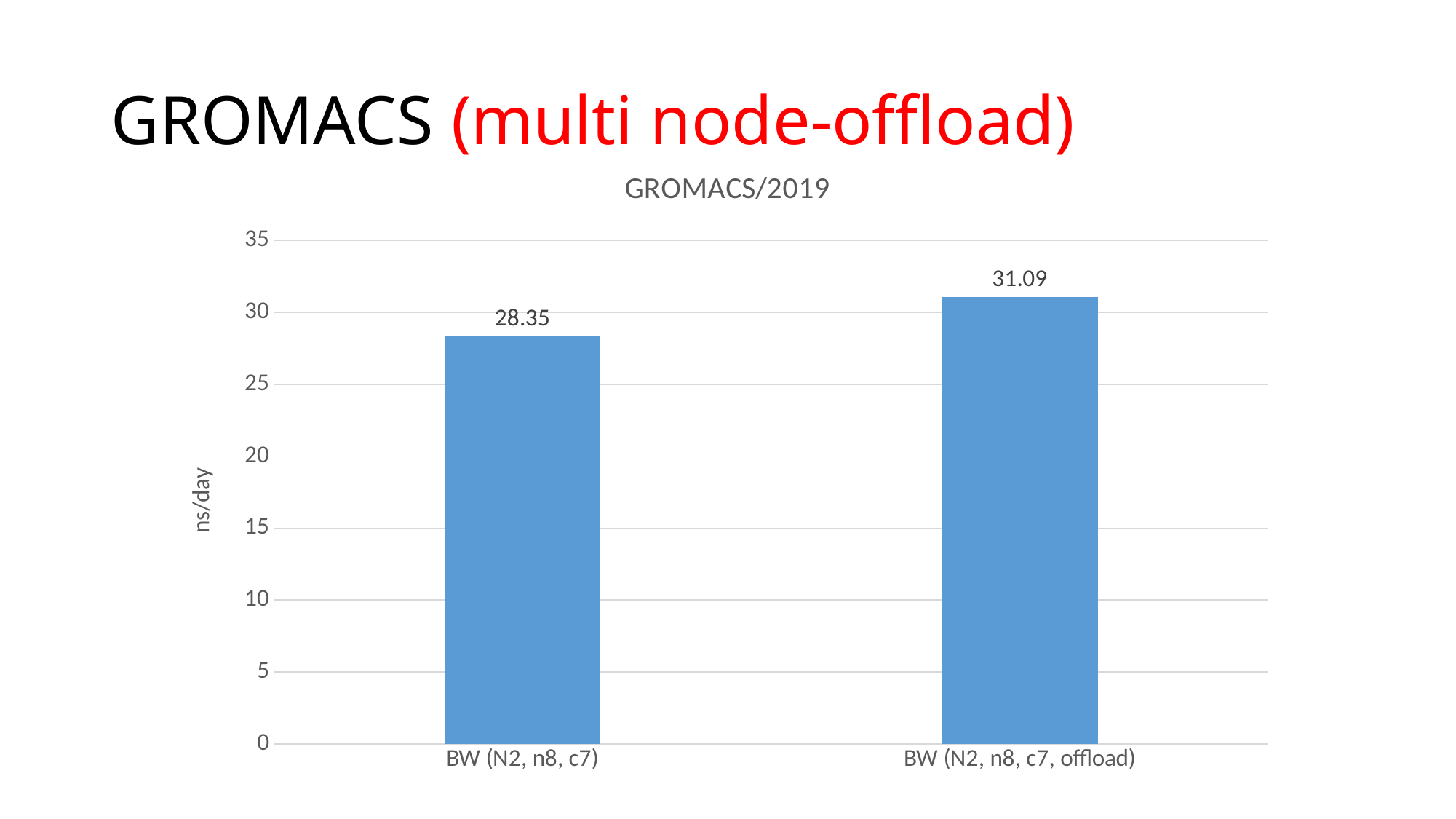
What is the label of the vertical axis? ns/day Is the value for BW (N2, n8, c7, offload) greater or less than 30? greater What is the value for BW (N2, n8, c7)? 28.35 What kind of chart is shown on the slide? bar chart What is the difference between the values for BW (N2, n8, c7, offload) and BW (N2, n8, c7)? 2.74 What is the title of the chart? GROMACS/2019 What is the value for BW (N2, n8, c7, offload)? 31.09 Which category has the lowest value? BW (N2, n8, c7) Which category has the highest value? BW (N2, n8, c7, offload) How many categories are shown in the chart? 2 Which is larger, the value for BW (N2, n8, c7) or BW (N2, n8, c7, offload)? BW (N2, n8, c7, offload) Is the value for BW (N2, n8, c7) greater or less than 30? less